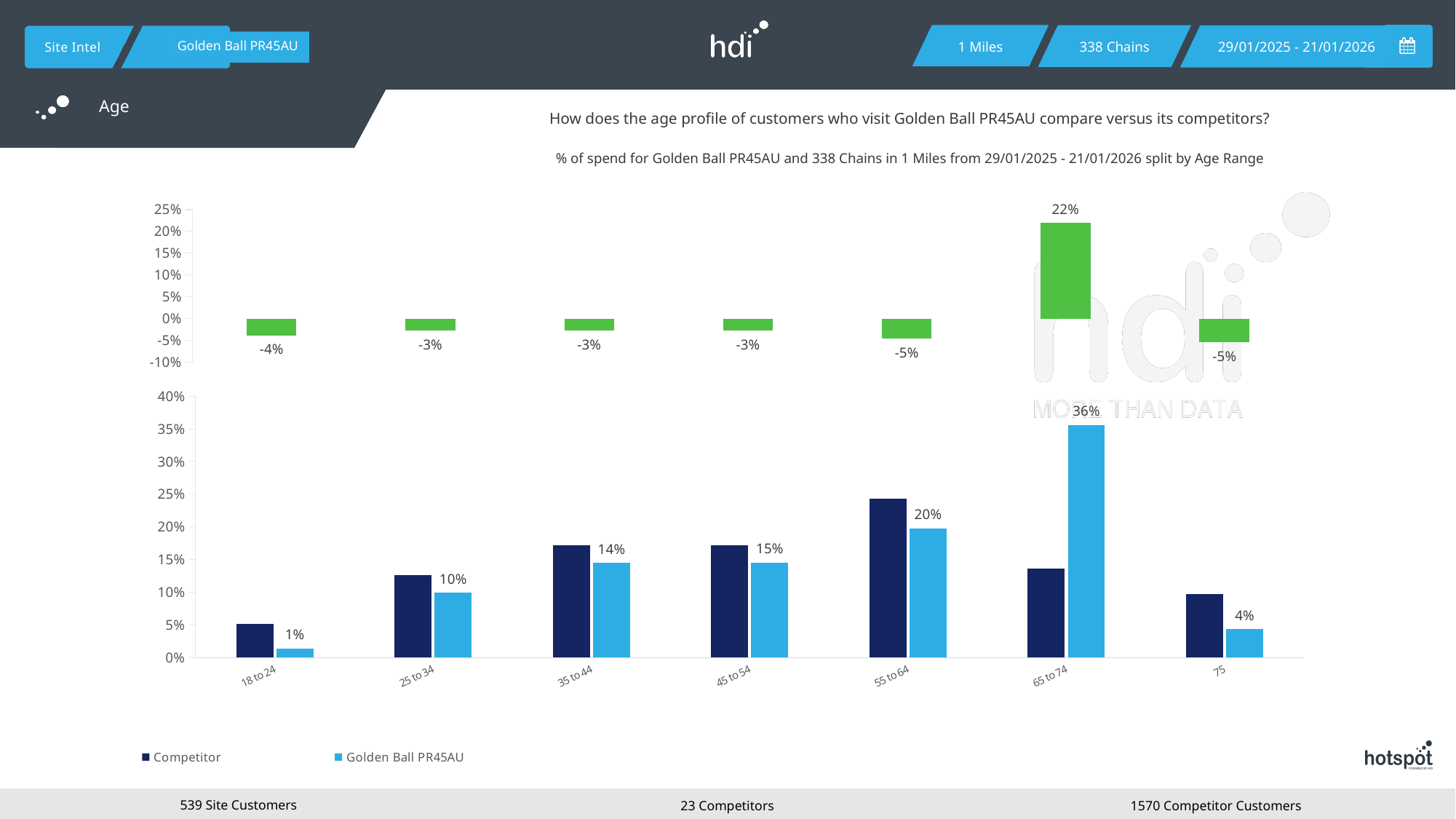
In the top chart, what is the value shown for the 65 to 74 age range? 22% In the bottom chart, what is the Golden Ball PR45AU value for the 65 to 74 age range? 36% In the bottom chart, is the Competitor value for the 55 to 64 age range greater or less than 20%? greater How many age range categories are shown on the x axis of the bottom chart? 7 In the bottom chart, for the 65 to 74 age range, which is larger: the Competitor value or the Golden Ball PR45AU value? Golden Ball PR45AU What kind of chart is the bottom chart? Bar chart In the bottom chart, what is the difference between the Golden Ball PR45AU values for 65 to 74 and 55 to 64? 16% In the bottom chart, what is the Golden Ball PR45AU value for the 18 to 24 age range? 1% In the top chart, what is the value shown for the 18 to 24 age range? -4% In the bottom chart, which age range has the lowest Golden Ball PR45AU value? 18 to 24 In the bottom chart, which age range has the highest Golden Ball PR45AU value? 65 to 74 How many series does the legend of the bottom chart list? 2